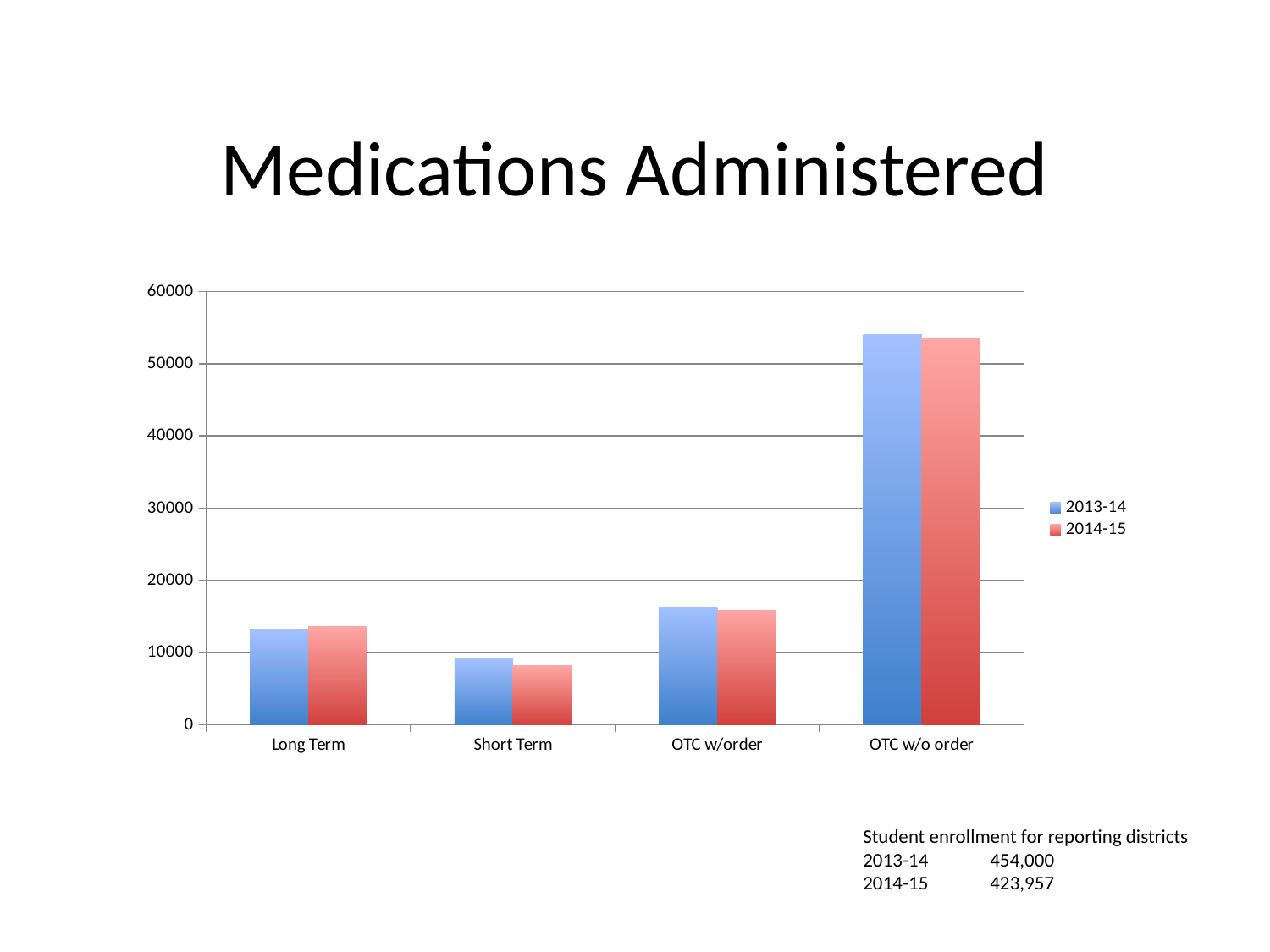
How many series does the legend list? 2 For Short Term, which series has the larger value, 2013-14 or 2014-15? 2013-14 What is the title of the chart? Medications Administered Is the 2013-14 value for Long Term greater or less than 10000? greater Which category has the highest number of medications administered? OTC w/o order Is the 2013-14 value for OTC w/o order greater or less than 50000? greater What kind of chart is shown on the slide? bar chart Is the 2013-14 value for OTC w/order greater or less than 20000? less How many categories are shown on the x axis? 4 For 2013-14, which is larger, OTC w/order or OTC w/o order? OTC w/o order Which category has the lowest number of medications administered? Short Term